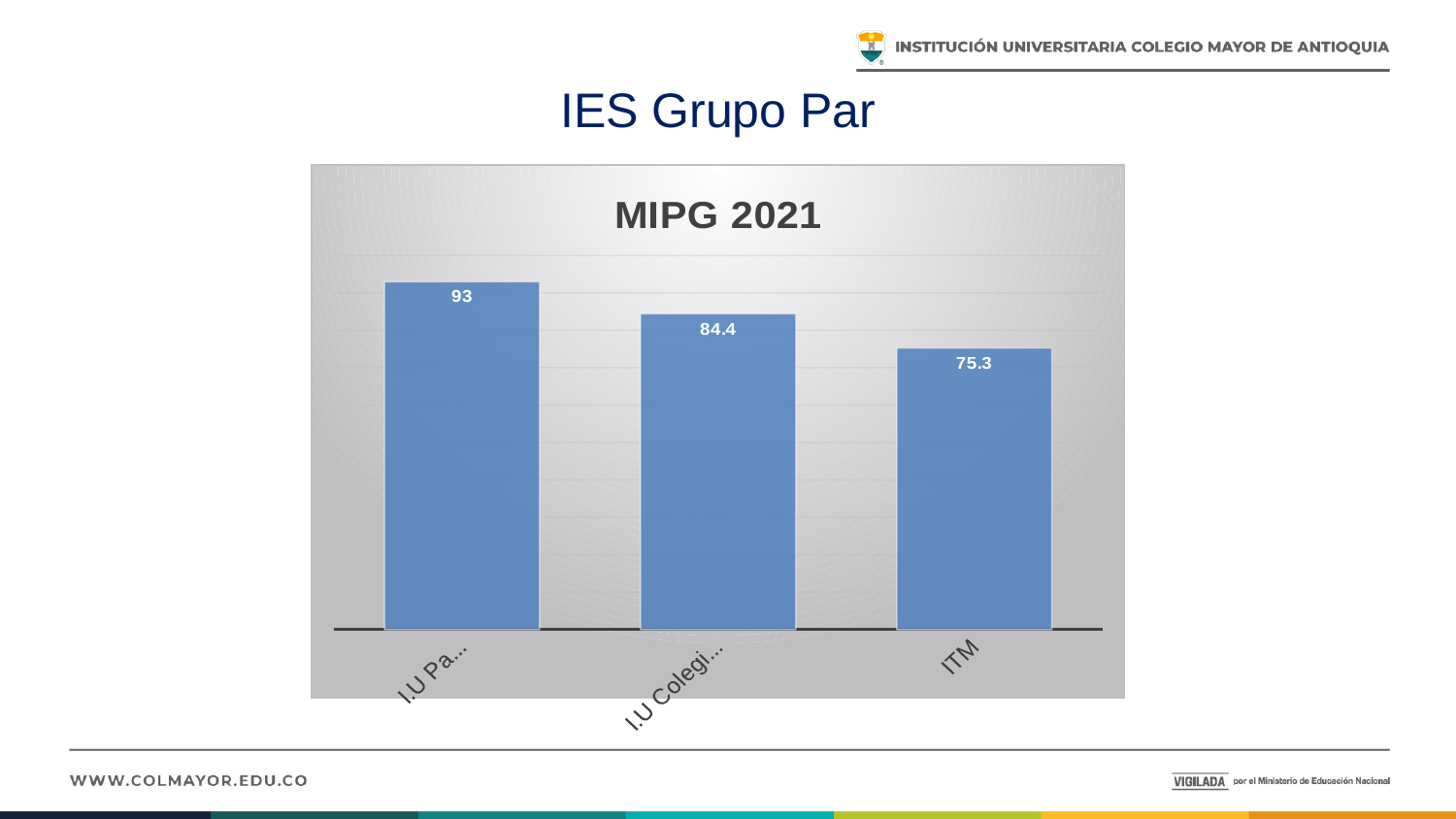
What is the difference between the middle bar (84.4) and ITM (75.3) in the MIPG 2021 chart? 9.1 How many bars are shown in the MIPG 2021 chart? 3 Do the values rise or fall from left to right in the MIPG 2021 chart? fall What kind of chart is shown on the slide? bar chart What is the value for ITM in the MIPG 2021 chart? 75.3 What is the highest value shown in the MIPG 2021 chart? 93 What is the value shown on the middle bar of the MIPG 2021 chart? 84.4 What is the difference between the highest value (93) and the value for ITM in the MIPG 2021 chart? 17.7 What is the title of the chart on the slide? MIPG 2021 Which category has the lowest value in the MIPG 2021 chart? ITM What is the value shown on the leftmost bar of the MIPG 2021 chart? 93 Is the value for ITM larger or smaller than the value of the middle bar in the MIPG 2021 chart? smaller